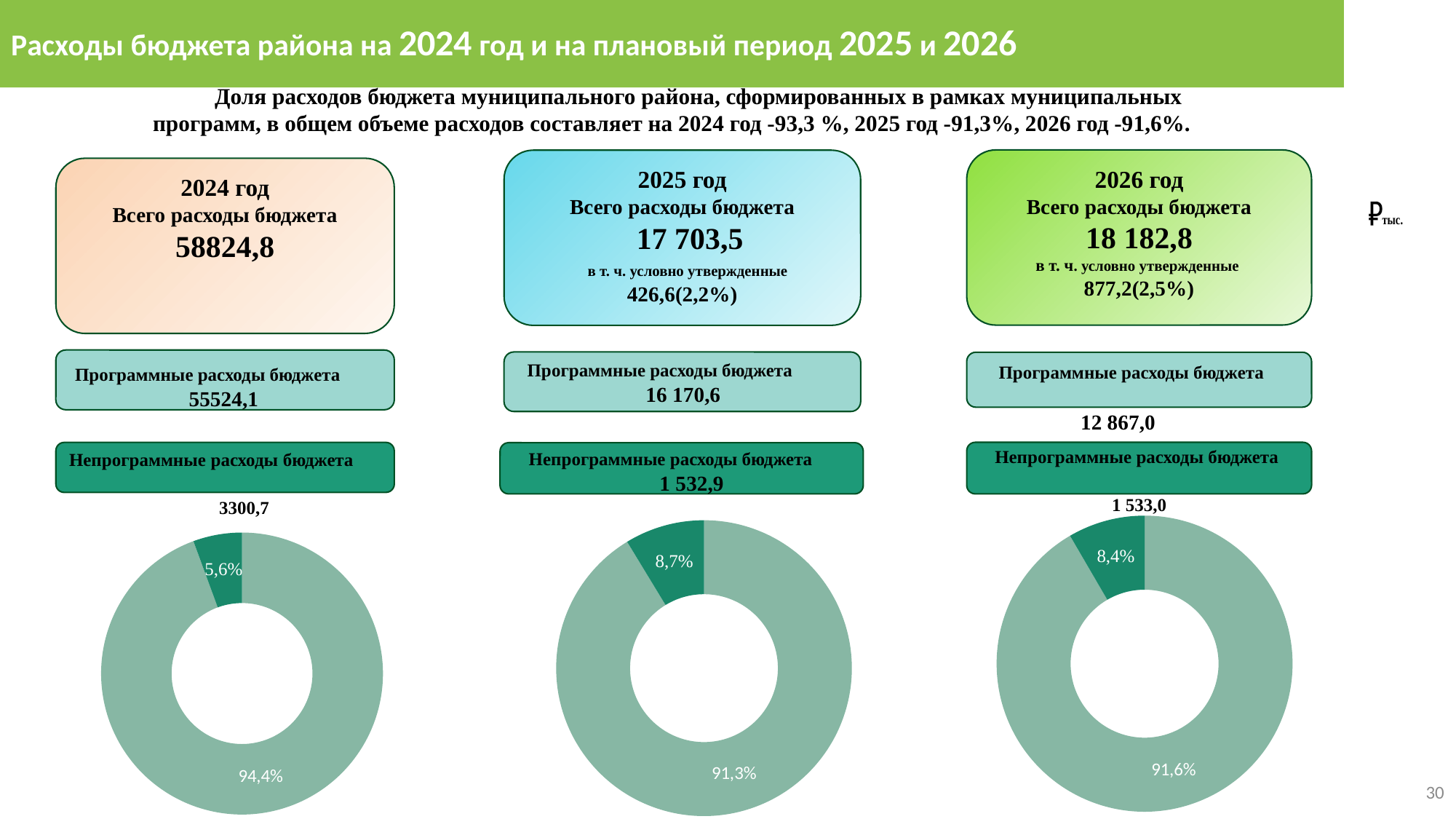
In the middle donut chart (2025 год), what percentage is shown for the large light-green slice? 91,3% How many donut charts are shown on the slide? 3 How many slices does each donut chart contain? 2 What kind of chart is used for the three charts at the bottom of the slide? Donut (pie) chart In the right donut chart (2026 год), what percentage is shown for the small dark-green slice? 8,4% In the left donut chart (2024 год), which slice is the largest? The light-green slice, 94,4% Which is larger: the small dark-green slice in the middle donut chart (2025 год) or the small dark-green slice in the right donut chart (2026 год)? The middle chart (2025 год), 8,7% In the right donut chart (2026 год), what percentage is shown for the large light-green slice? 91,6% In the left donut chart (2024 год), what percentage is shown for the small dark-green slice? 5,6% In the left donut chart (2024 год), what percentage is shown for the large light-green slice? 94,4% In the left donut chart (2024 год), what is the difference between the large slice and the small slice? 88,8% In the middle donut chart (2025 год), what percentage is shown for the small dark-green slice? 8,7%